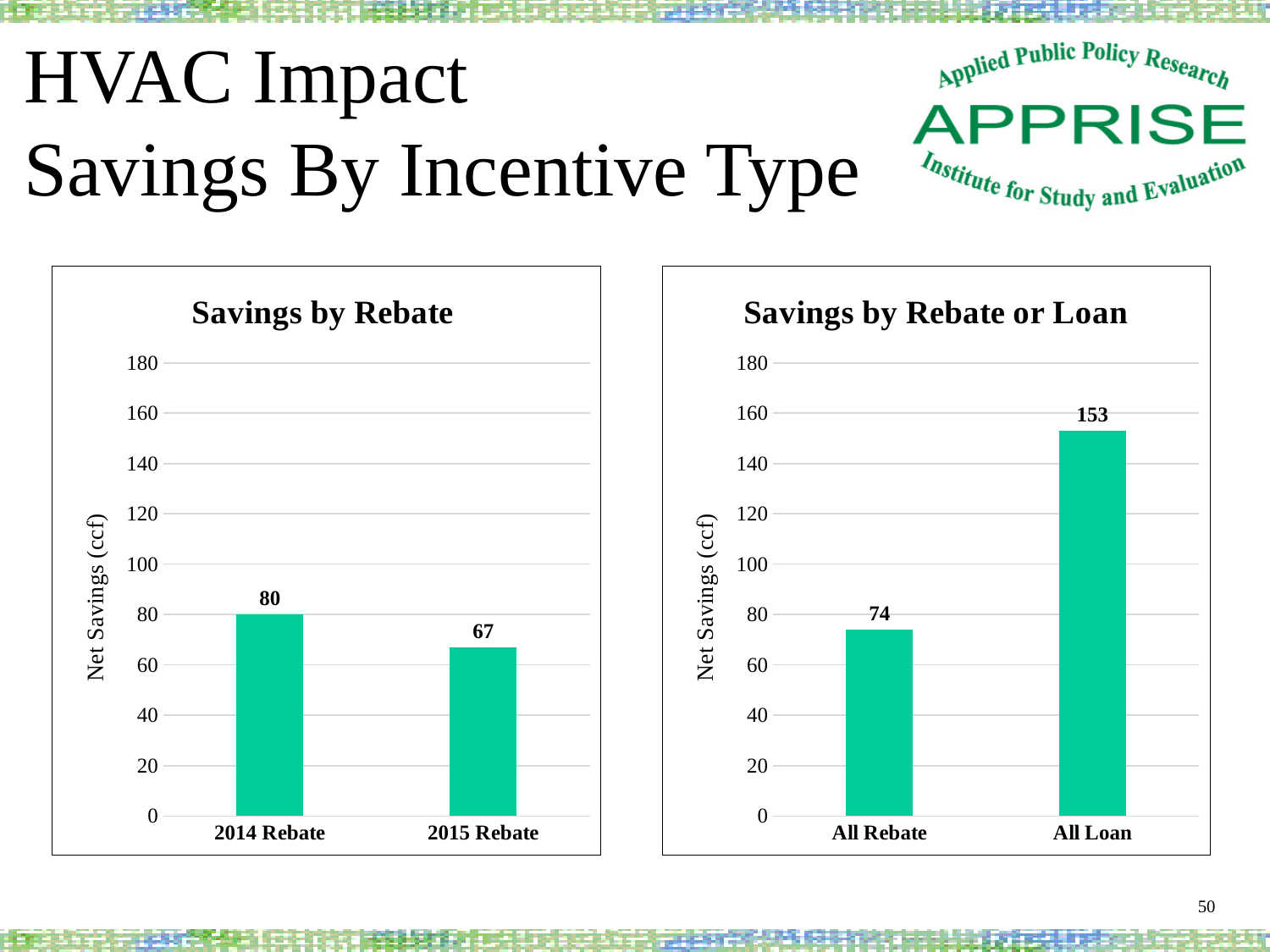
What is the y-axis label on the 'Savings by Rebate' chart? Net Savings (ccf) In the 'Savings by Rebate' chart, how many categories are shown on the x axis? 2 What kind of chart is the 'Savings by Rebate or Loan' chart? Bar chart In the 'Savings by Rebate' chart, what is the net savings value for 2014 Rebate? 80 In the 'Savings by Rebate' chart, what is the difference between the 2014 Rebate and 2015 Rebate values? 13 In the 'Savings by Rebate or Loan' chart, what is the net savings value for All Rebate? 74 In the 'Savings by Rebate or Loan' chart, what is the net savings value for All Loan? 153 In the 'Savings by Rebate or Loan' chart, what is the difference between the All Loan and All Rebate values? 79 In the 'Savings by Rebate or Loan' chart, which category has the lowest net savings? All Rebate In the 'Savings by Rebate' chart, which category has the higher net savings? 2014 Rebate In the 'Savings by Rebate' chart, what is the net savings value for 2015 Rebate? 67 In the 'Savings by Rebate or Loan' chart, is the value for All Loan greater or less than 140? greater